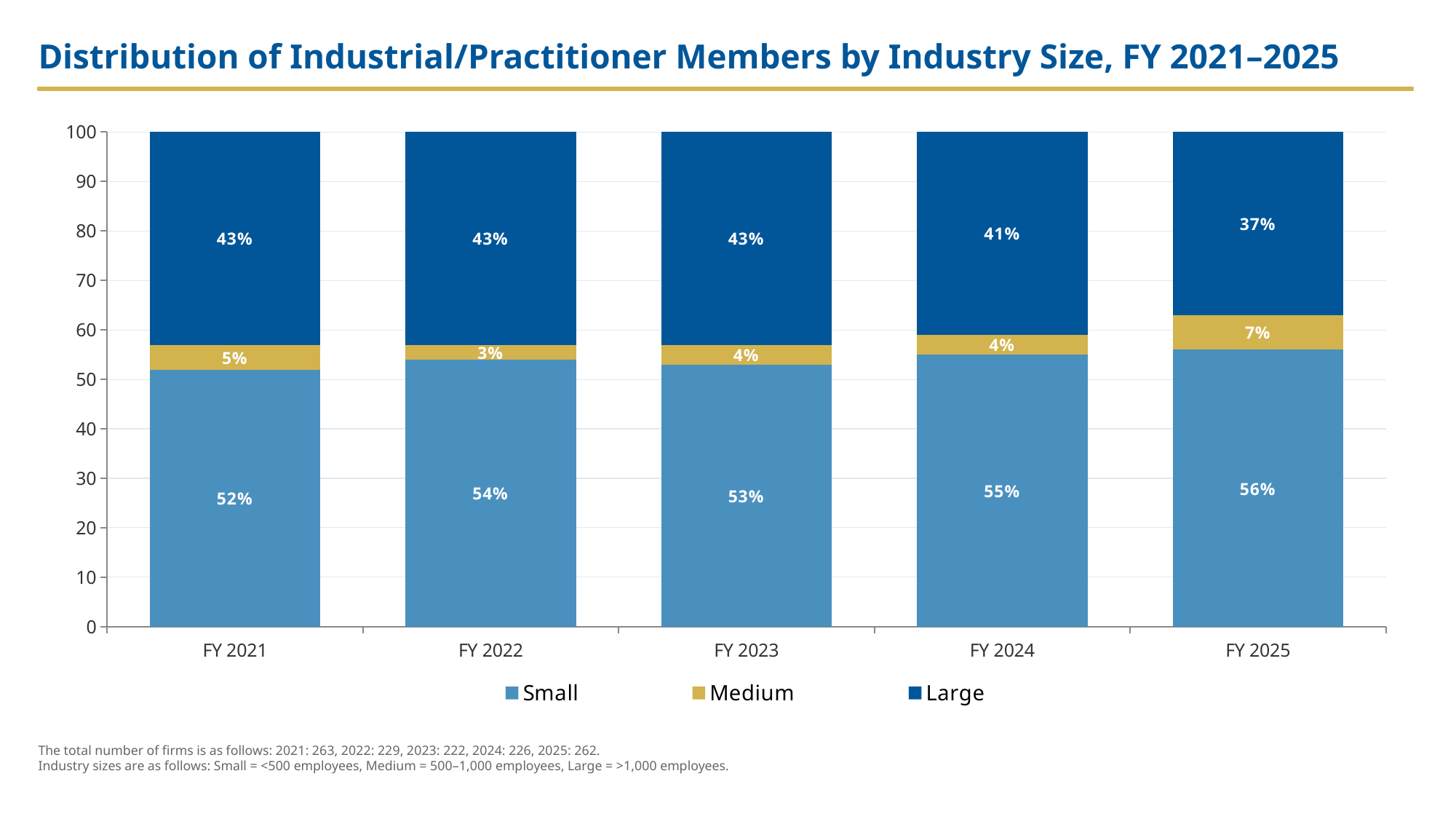
Does the Small share rise or fall from FY 2023 to FY 2025? Rise In which fiscal year was the Medium share highest? FY 2025 What is the combined share of Medium and Large firms in FY 2025? 44% What percentage of members were from Small firms in FY 2025? 56% What is the difference between the Small share in FY 2025 and the Small share in FY 2021? 4% What percentage of members were from Medium firms in FY 2022? 3% What percentage of members were from Large firms in FY 2024? 41% How many fiscal years are shown on the x axis? 5 In which fiscal year was the Large share lowest? FY 2025 What kind of chart is shown on the slide? Stacked bar chart Which is larger in FY 2023: the Small share or the Large share? Small How many series does the legend list? 3